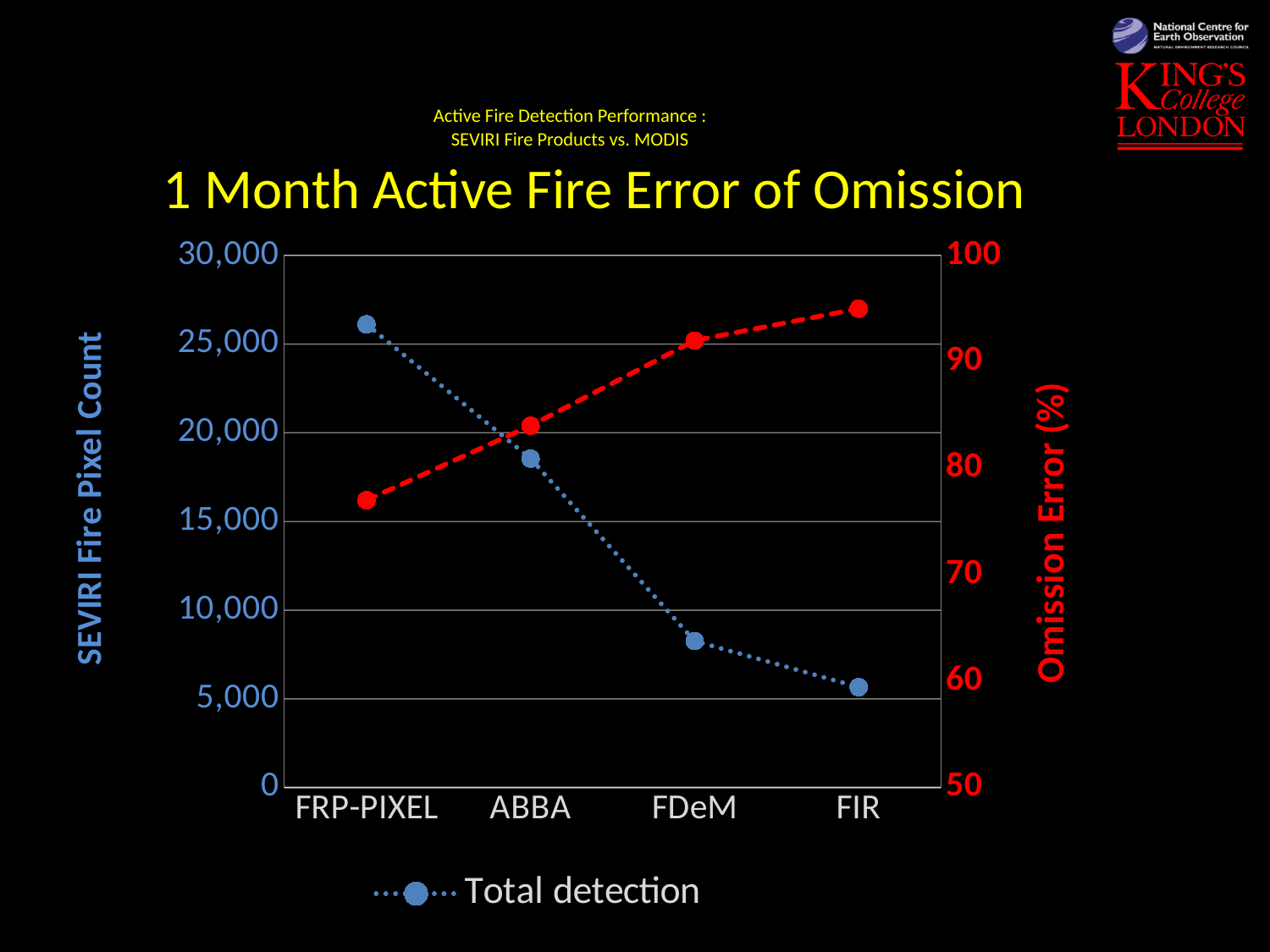
Which category has the highest Omission Error (%)? FIR Which has a higher Total detection, ABBA or FDeM? ABBA Which category has the lowest Omission Error (%)? FRP-PIXEL Which category has the highest Total detection (SEVIRI Fire Pixel Count)? FRP-PIXEL What kind of chart is shown on the slide? Line chart Is the Total detection value for FDeM greater or less than 10,000? less Which category has the lowest Total detection (SEVIRI Fire Pixel Count)? FIR Is the Omission Error (%) for FRP-PIXEL greater or less than 80? less How many categories are shown on the x axis of the chart? 4 Is the Total detection value for ABBA greater or less than 20,000? less Does the Total detection series rise or fall from FRP-PIXEL to FIR? Fall How many series does the chart's legend list? 1